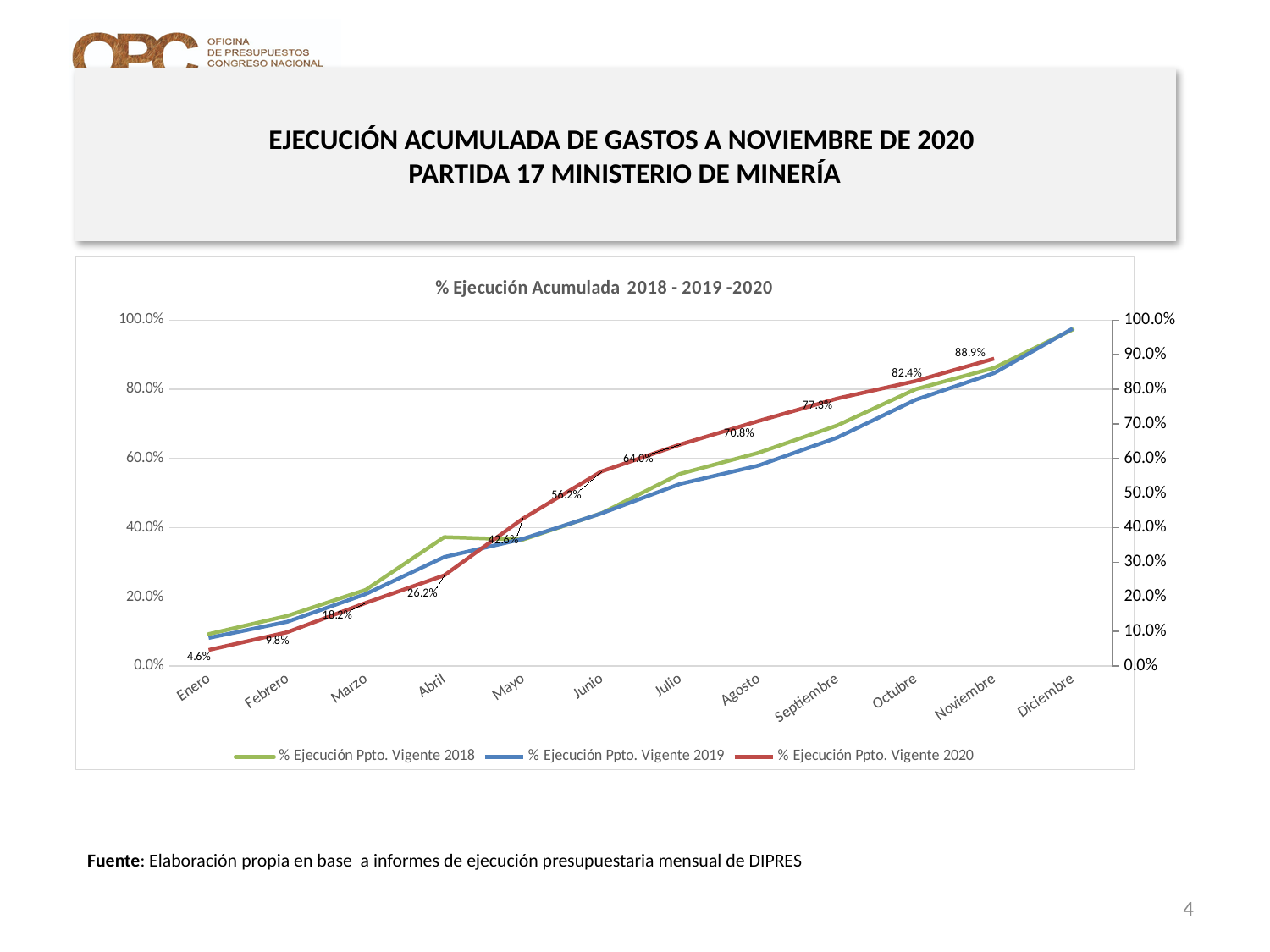
What is the value for % Ejecución Ppto. Vigente 2020 in Noviembre? 88.9% Is the value for % Ejecución Ppto. Vigente 2019 in Diciembre greater or less than 90.0%? greater What is the difference between the 2020 values for Noviembre and Octubre? 6.5% What is the title of the chart? % Ejecución Acumulada 2018 - 2019 -2020 What type of chart is shown on the slide? line chart How many months are shown on the x axis? 12 Does the % Ejecución Ppto. Vigente 2020 series rise or fall from Enero to Noviembre? rise What is the value for % Ejecución Ppto. Vigente 2020 in Enero? 4.6% What is the value for % Ejecución Ppto. Vigente 2020 in Agosto? 70.8% What is the difference between the 2020 values for Junio and Mayo? 13.6% What is the value for % Ejecución Ppto. Vigente 2020 in Mayo? 42.6% How many series does the legend list? 3